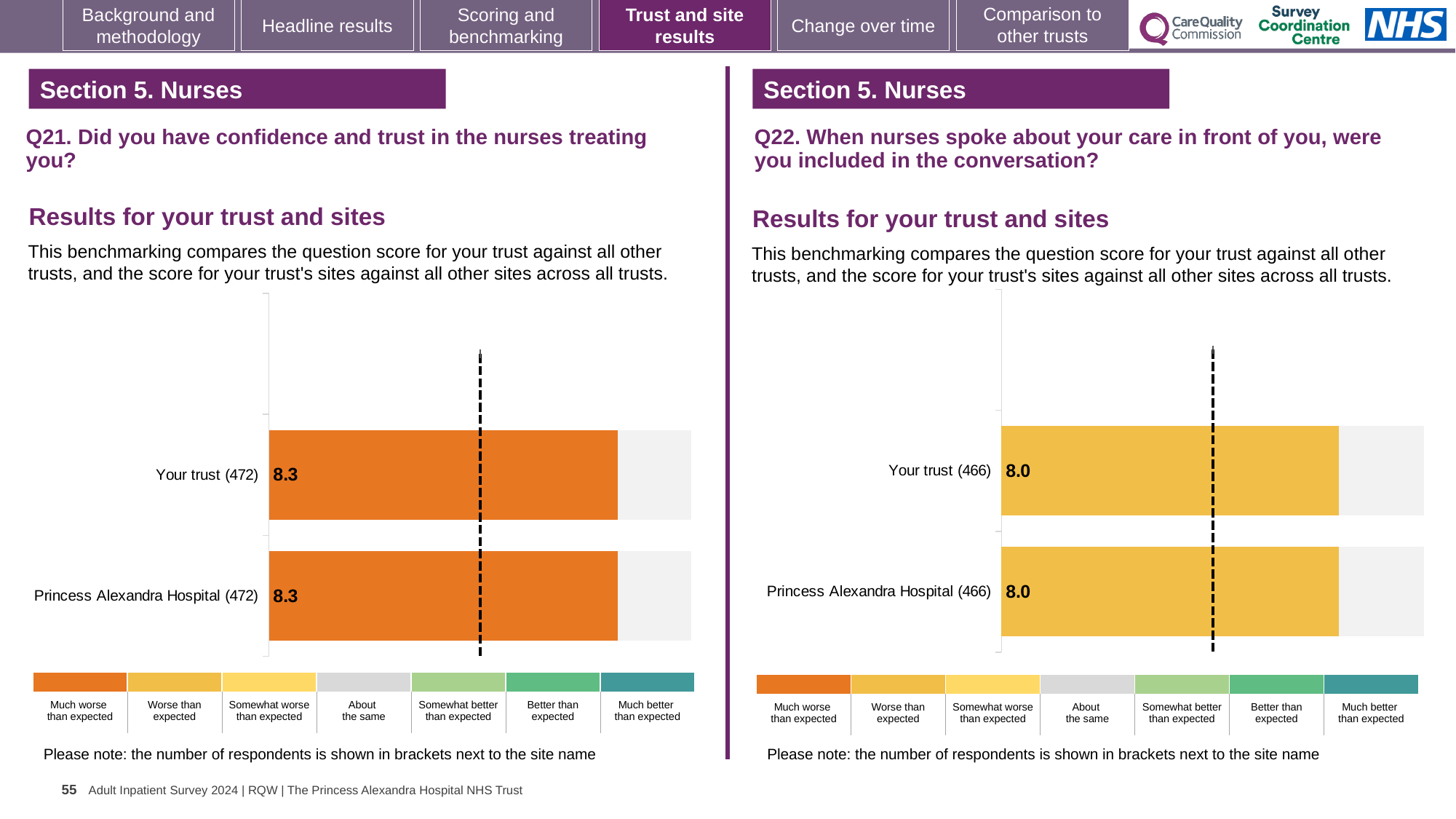
In the Q22 chart on the right, how many respondents are shown in brackets for Princess Alexandra Hospital? 466 In the Q22 chart on the right, what is the score for Princess Alexandra Hospital? 8.0 In the Q21 chart on the left, how many respondents are shown in brackets for Your trust? 472 What type of chart is used for the Q21 results on the left? Bar chart How many bars are plotted in the Q22 chart on the right? 2 In the Q22 chart on the right, what is the score for Your trust? 8.0 Is the Your trust score in the Q21 chart on the left larger than the Your trust score in the Q22 chart on the right? Yes In the Q21 chart on the left, what is the score for Your trust? 8.3 How many bars are plotted in the Q21 chart on the left? 2 In the Q21 chart on the left, what is the difference between the Your trust score and the Princess Alexandra Hospital score? 0.0 In the Q22 chart on the right, what is the difference between the Your trust score and the Princess Alexandra Hospital score? 0.0 In the Q21 chart on the left, what is the score for Princess Alexandra Hospital? 8.3